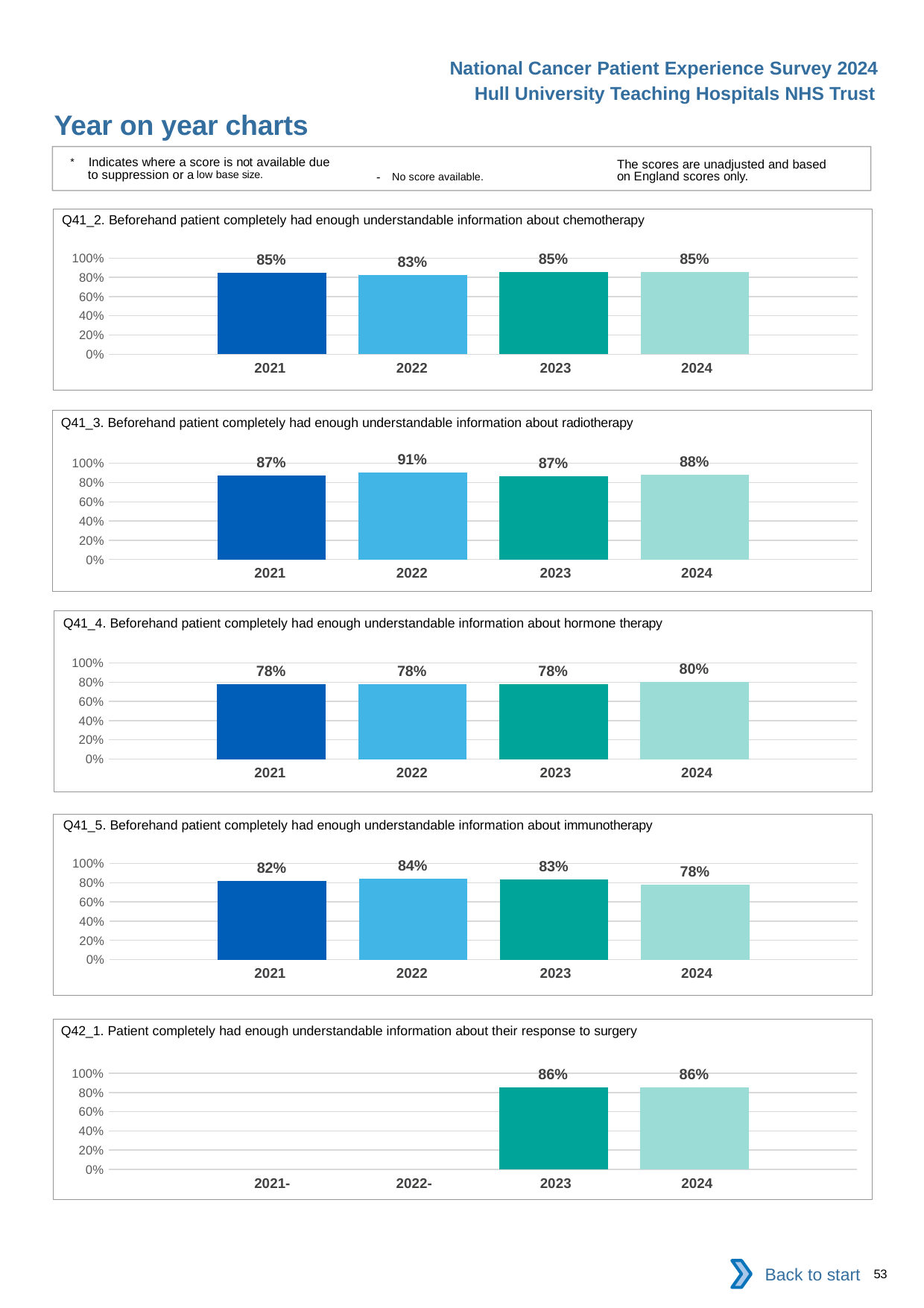
In the Q41_5 chart (immunotherapy), what is the difference between the 2021 and 2024 values? 4% In the Q41_4 chart (hormone therapy), is the value for 2021 greater or less than 60%? greater What type of chart is the Q41_2 chart (chemotherapy)? Bar chart In the Q41_5 chart (immunotherapy), which year has the lowest value? 2024 How many charts are shown on the slide? 5 In the Q42_1 chart (response to surgery), how many years have a bar plotted? 2 In the Q41_5 chart (immunotherapy), which is larger, the value for 2022 or the value for 2024? 2022 In the Q41_2 chart (chemotherapy), what is the value for 2022? 83% In the Q41_3 chart (radiotherapy), what is the difference between the 2022 and 2024 values? 3% In the Q41_3 chart (radiotherapy), which year has the highest value? 2022 In the Q42_1 chart (response to surgery), what is the value for 2023? 86% In the Q41_4 chart (hormone therapy), what is the value for 2024? 80%